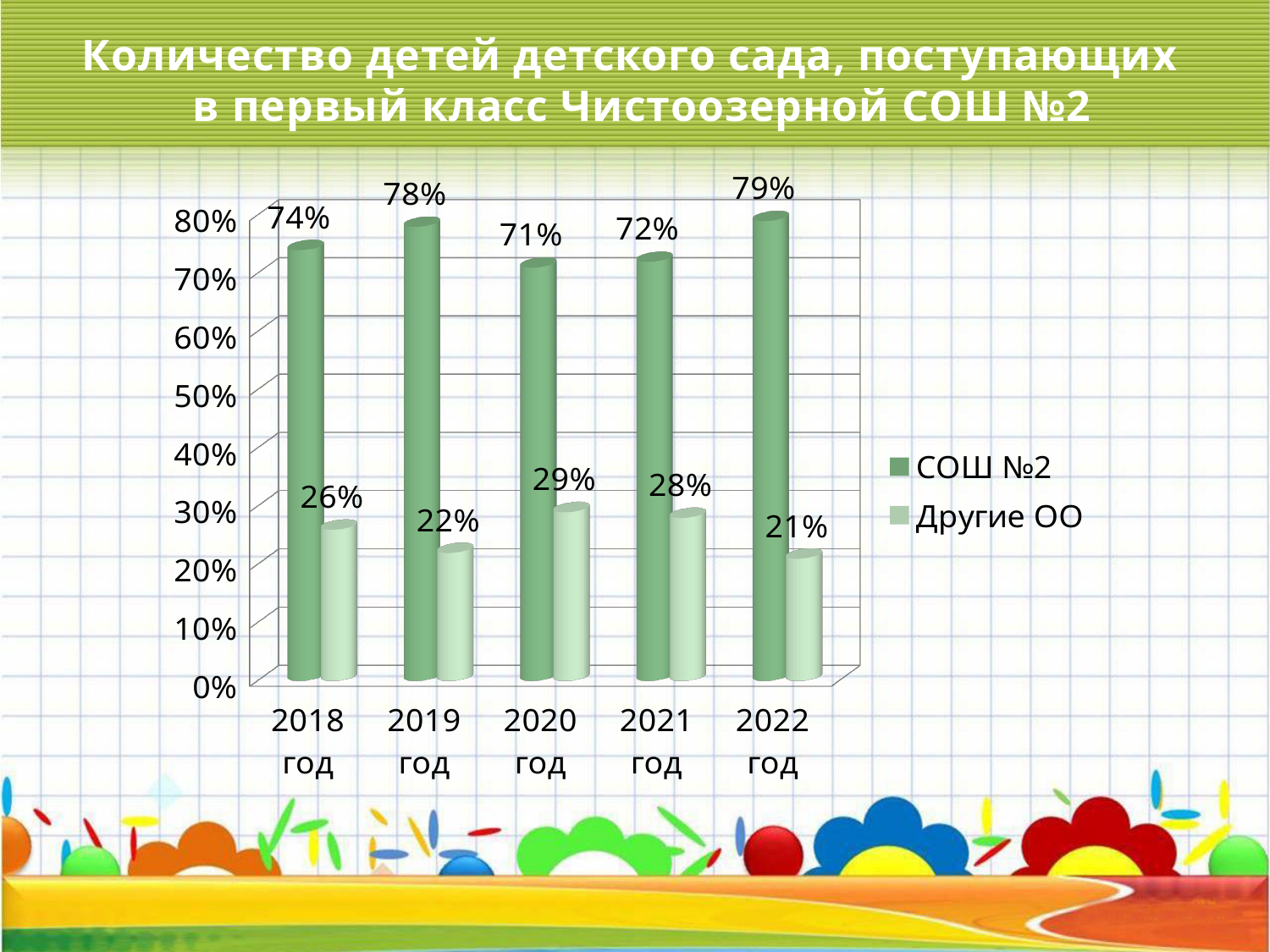
What are the two series listed in the legend? СОШ №2 and Другие ОО Which is larger in 2021 год: СОШ №2 or Другие ОО? СОШ №2 How many years are shown on the x axis? 5 How many series does the legend list? 2 What is the value for Другие ОО in 2020 год? 29% What is the value for СОШ №2 in 2018 год? 74% Is the value for Другие ОО in 2018 год greater or less than 30%? less What is the difference between the СОШ №2 and Другие ОО values in 2019 год? 56% What kind of chart is shown on the slide? bar chart In which year is the value for Другие ОО the lowest? 2022 год What is the value for СОШ №2 in 2022 год? 79% In which year is the value for СОШ №2 the highest? 2022 год